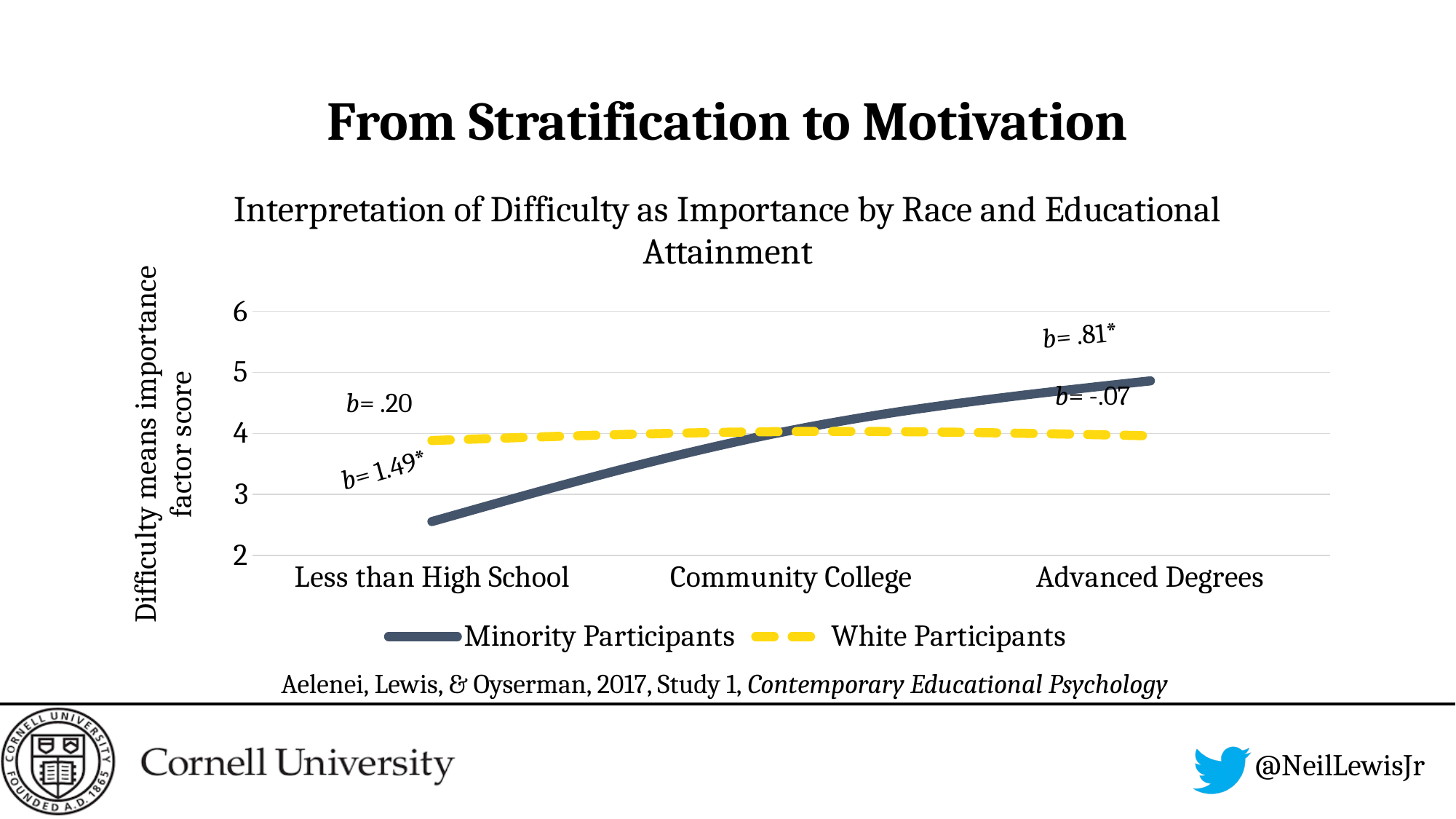
Do the values for Minority Participants rise or fall from Less than High School to Advanced Degrees? rise Is the value for Minority Participants at Advanced Degrees greater or less than 4? greater What kind of chart is shown on the slide? line chart How many series does the legend list? 2 Is the value for White Participants at Less than High School greater or less than 3? greater Is the value for Minority Participants at Less than High School greater or less than 3? less What is the label on the y axis of the chart? Difficulty means importance factor score How many educational attainment categories are shown on the x axis? 3 At Less than High School, which series has the higher value, Minority Participants or White Participants? White Participants Which series is drawn with a dashed yellow line? White Participants At Advanced Degrees, which series has the higher value, Minority Participants or White Participants? Minority Participants